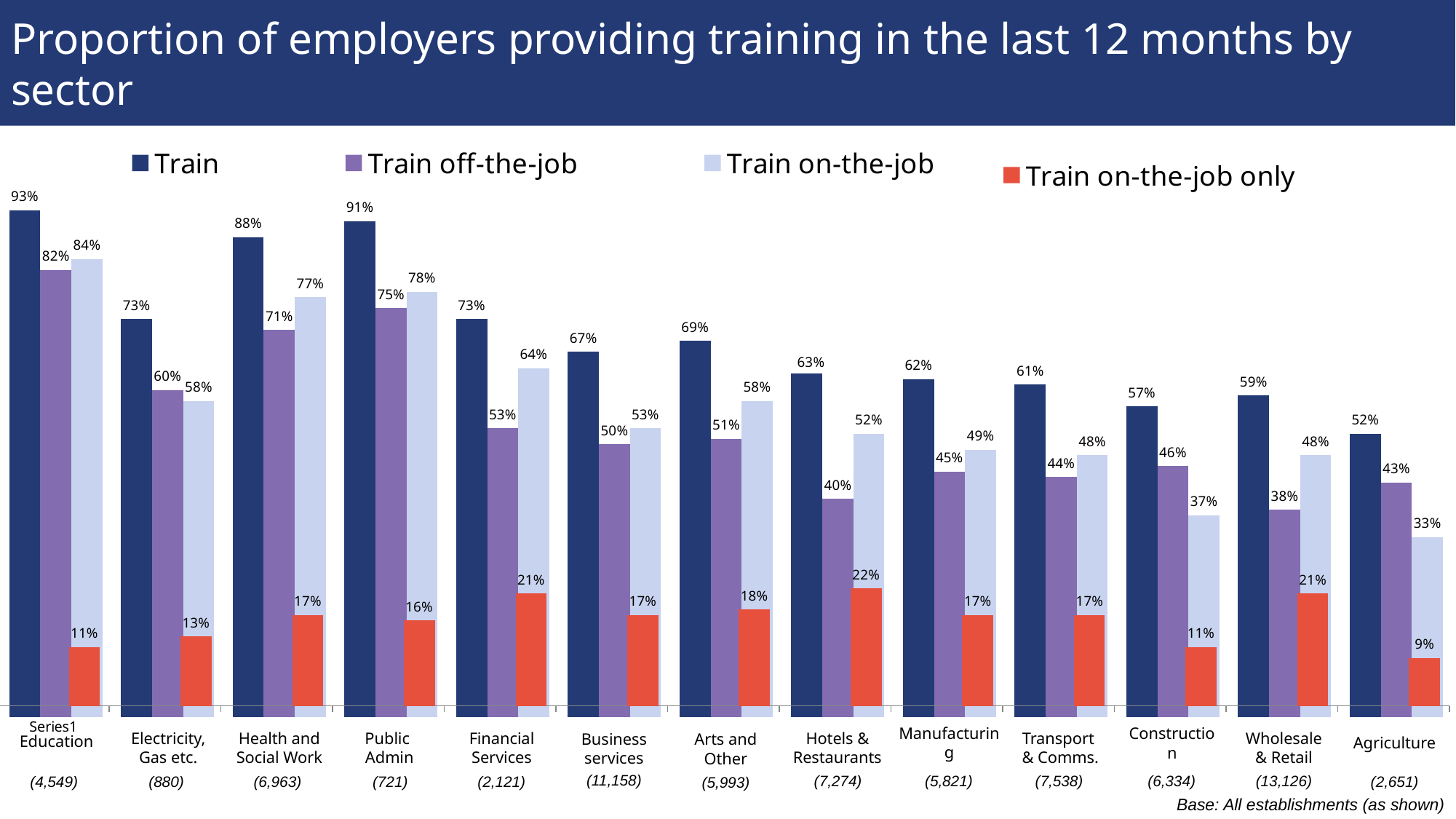
What is the difference between the 'Train' values for Education and Agriculture? 41 percentage points What proportion of employers in Public Admin provide training (the 'Train' series)? 91% What is the 'Train off-the-job' value for Hotels & Restaurants? 40% Which sector has the highest 'Train' value? Education How many sectors are shown on the x axis? 13 Do the 'Train' values generally rise or fall moving from left to right across the sectors? Fall What is the 'Train on-the-job only' value for Financial Services? 21% Which is larger for Construction: 'Train off-the-job' or 'Train on-the-job'? Train off-the-job Which sector has the lowest 'Train on-the-job only' value? Agriculture What kind of chart is shown on the slide? Bar chart What base size is shown for Wholesale & Retail? (13,126) How many series does the legend list? 4